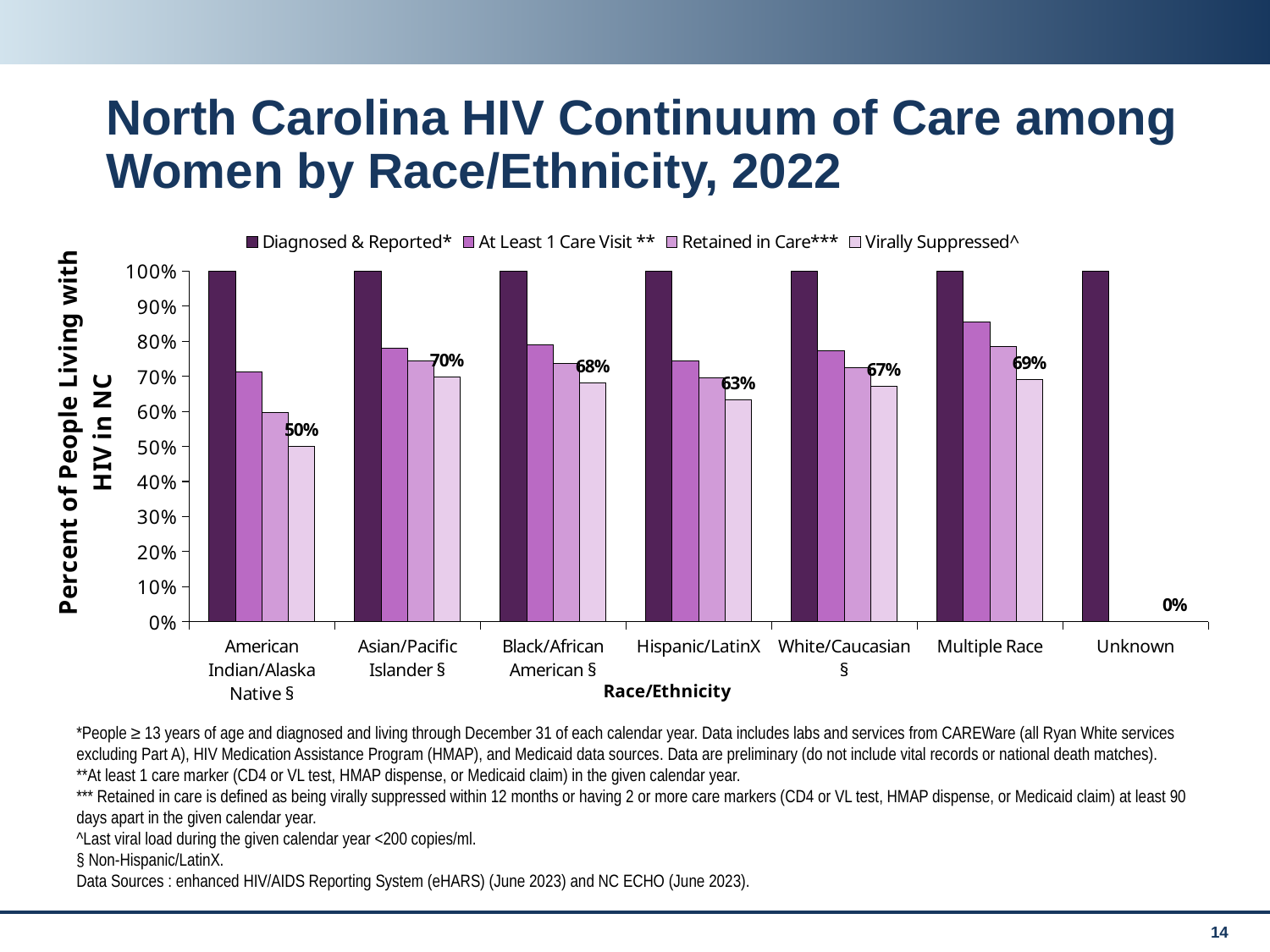
What is the Virally Suppressed value for American Indian/Alaska Native? 50% What is the Diagnosed & Reported value for Hispanic/LatinX? 100% How many race/ethnicity categories are shown on the x axis? 7 What is the difference between the Virally Suppressed values for Asian/Pacific Islander and American Indian/Alaska Native? 20% Is the At Least 1 Care Visit value for Multiple Race greater or less than 80%? greater Is the Virally Suppressed value larger for Black/African American or for White/Caucasian? Black/African American Which race/ethnicity has the lowest Virally Suppressed value? Unknown How many series does the legend list? 4 What kind of chart is shown on the slide? bar chart What is the Virally Suppressed value for Multiple Race? 69% Which race/ethnicity has the highest Virally Suppressed value? Asian/Pacific Islander What is the Virally Suppressed value for Hispanic/LatinX? 63%